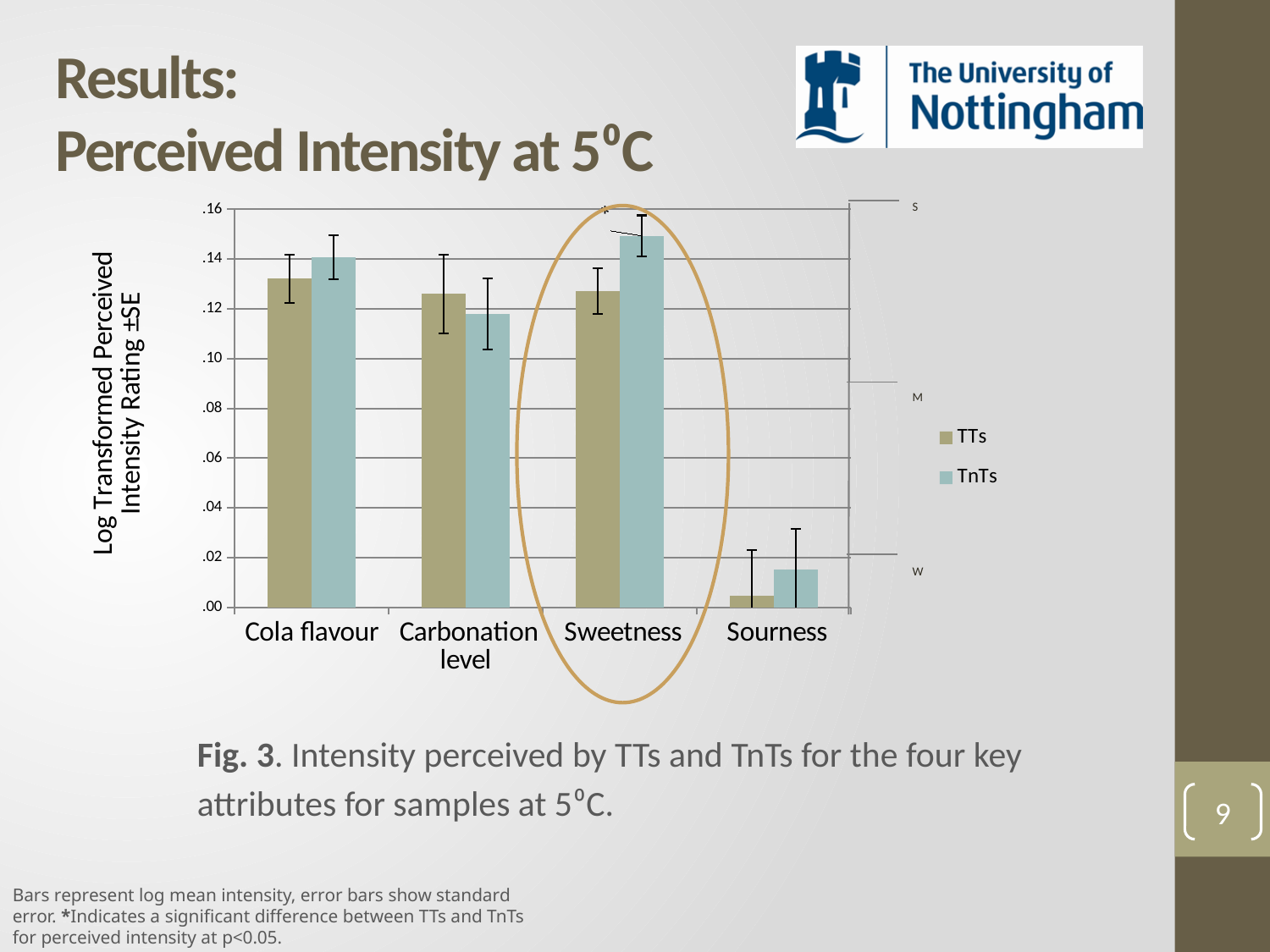
What are the two series named in the chart's legend? TTs and TnTs Is the TnTs value for Sweetness greater or less than .14? greater What kind of chart is shown on the slide? Bar chart How many attribute categories are shown on the x axis of the chart? 4 Is the TTs value for Cola flavour greater or less than .12? greater Which attribute on the chart is highlighted with an orange oval? Sweetness Is the TnTs value for Sourness greater or less than .02? less For Carbonation level, which series has the larger perceived intensity rating, TTs or TnTs? TTs Which attribute has the lowest perceived intensity rating for both TTs and TnTs? Sourness How many series does the chart's legend list? 2 For Sweetness, which series has the larger perceived intensity rating, TTs or TnTs? TnTs For the TnTs series, which attribute has the highest perceived intensity rating? Sweetness